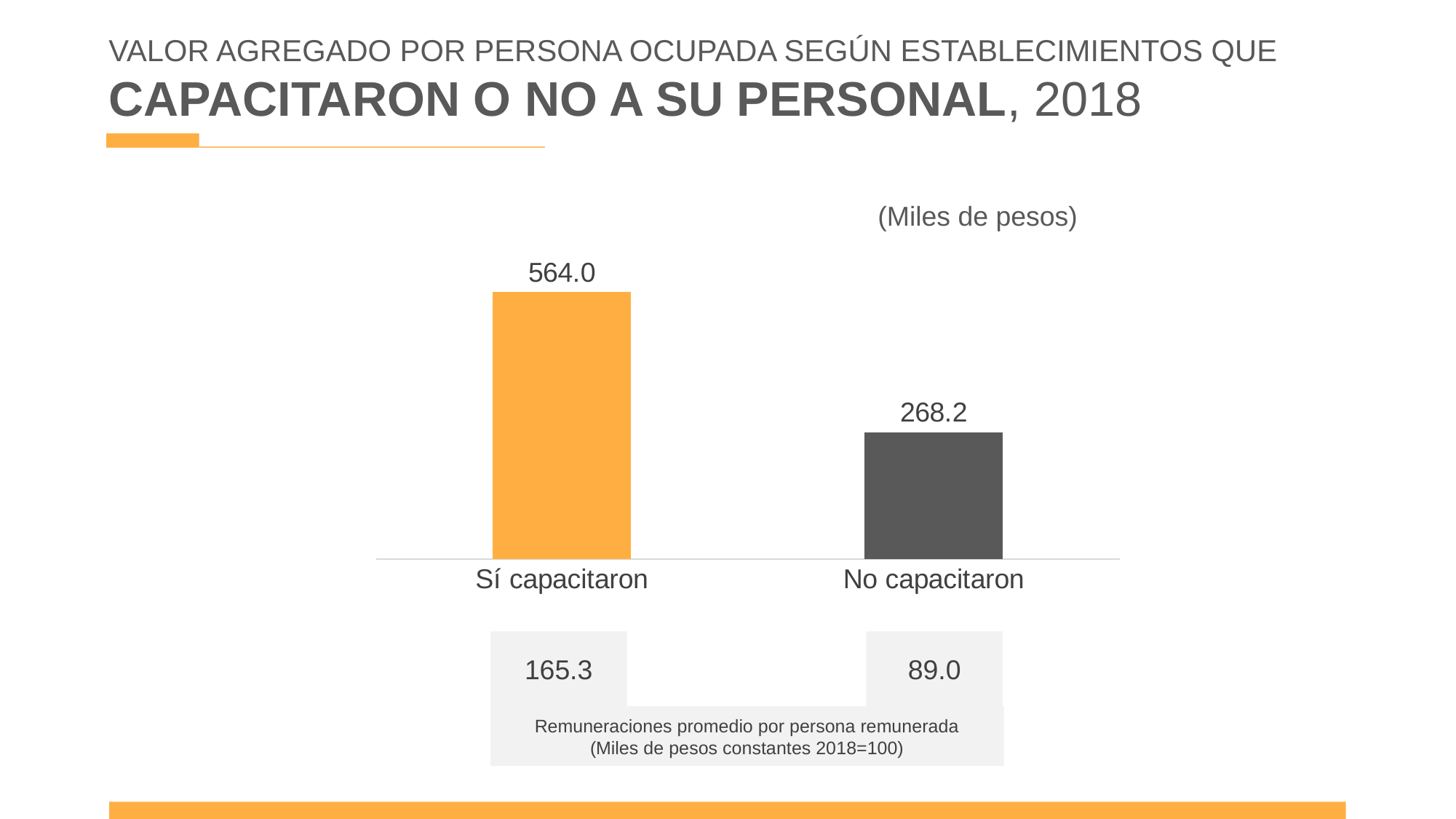
Which is larger, the value for Sí capacitaron or for No capacitaron? Sí capacitaron What is the value for No capacitaron? 268.2 What is the remuneraciones promedio por persona remunerada value shown below the chart for No capacitaron? 89.0 Which category has the lowest value? No capacitaron What kind of chart is shown on the slide? Bar chart What is the value for Sí capacitaron? 564.0 What colour is the bar for Sí capacitaron? Orange How many categories are shown in the chart? 2 What is the difference between the values for Sí capacitaron and No capacitaron? 295.8 What unit is shown above the chart? Miles de pesos What is the remuneraciones promedio por persona remunerada value shown below the chart for Sí capacitaron? 165.3 Which category has the highest value? Sí capacitaron